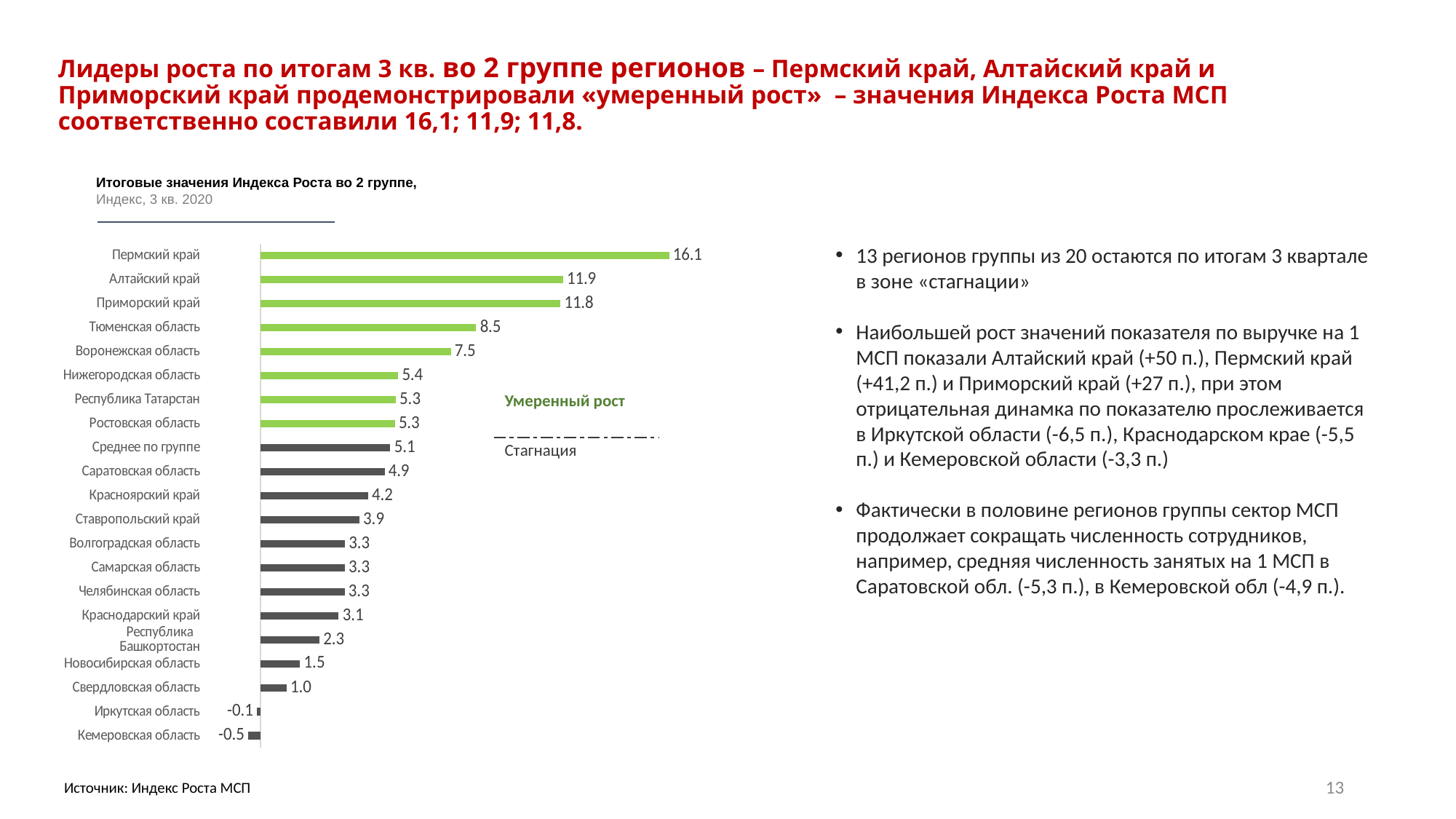
Какое значение показано для Кемеровской области? -0.5 Какое значение Индекса Роста показано для Пермского края? 16.1 На сколько значение Пермского края больше значения Алтайского края? 4.2 Какой регион имеет наибольшее значение Индекса Роста на диаграмме? Пермский край Сколько всего столбцов (включая «Среднее по группе») показано на диаграмме? 21 Какое значение показано для строки «Среднее по группе»? 5.1 Какой регион имеет наименьшее значение Индекса Роста на диаграмме? Кемеровская область Какого типа эта диаграмма? Столбчатая (bar chart) Что больше: значение Красноярского края или Ставропольского края? Красноярский край Какое значение показано для Тюменской области? 8.5 Какой подписью обозначена зона, в которую попадают зелёные столбцы? Умеренный рост На сколько значение Воронежской области больше значения Нижегородской области? 2.1